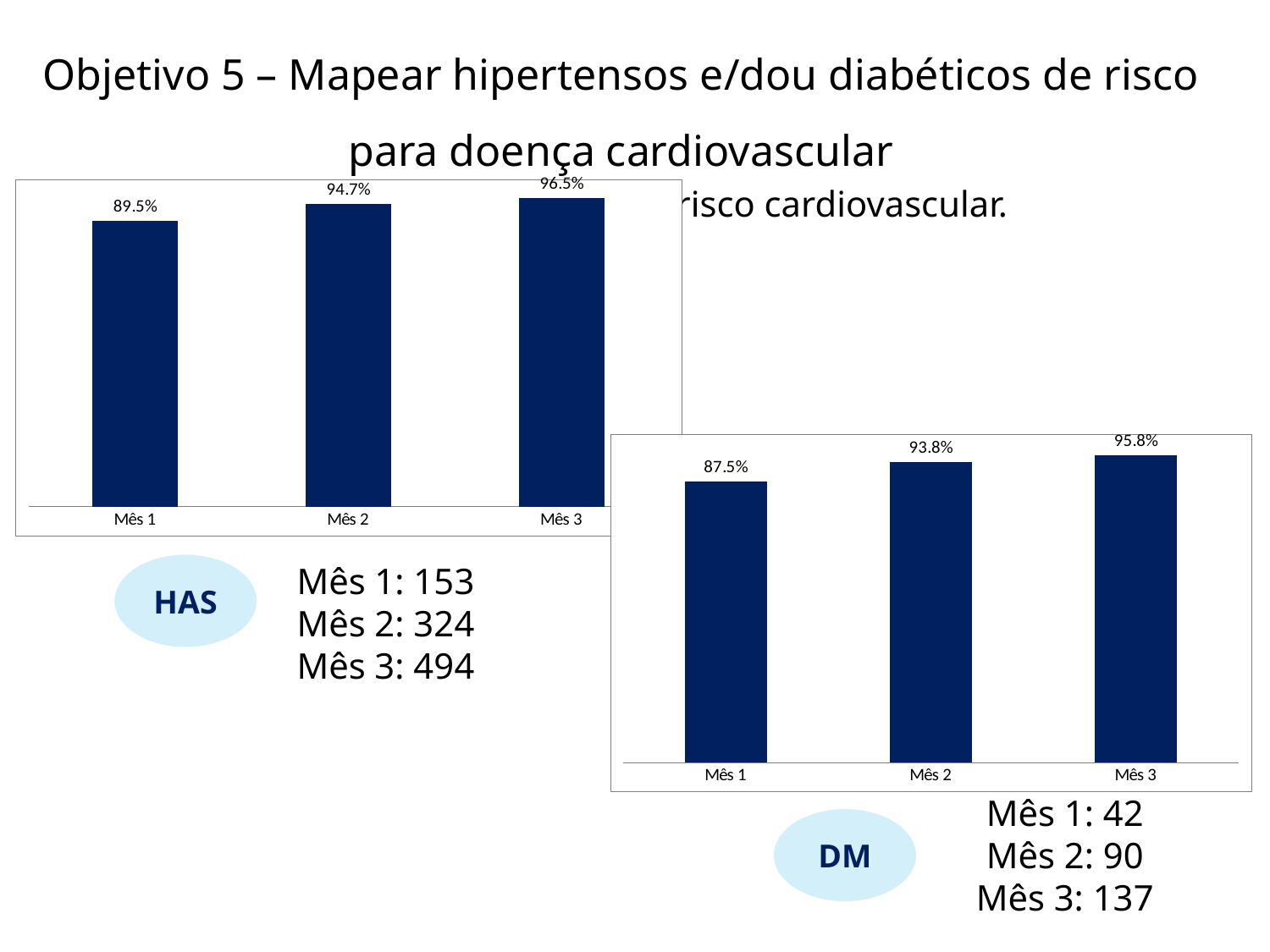
In the bottom-right chart (DM), which month has the lowest value? Mês 1 How many bars are in the top-left chart (HAS)? 3 In the bottom-right chart (DM), what is the value for Mês 1? 87.5% What kind of chart is the bottom-right chart (DM)? Bar chart In the top-left chart (HAS), do the values rise or fall from Mês 1 to Mês 3? Rise In the bottom-right chart (DM), what is the difference between the values for Mês 3 and Mês 1? 8.3% In the top-left chart (HAS), what is the value for Mês 3? 96.5% In the bottom-right chart (DM), which is larger, the value for Mês 2 or Mês 3? Mês 3 In the top-left chart (HAS), which month has the highest value? Mês 3 In the bottom-right chart (DM), what is the value for Mês 2? 93.8% In the top-left chart (HAS), what is the value for Mês 1? 89.5% In the top-left chart (HAS), what is the difference between the values for Mês 2 and Mês 1? 5.2%